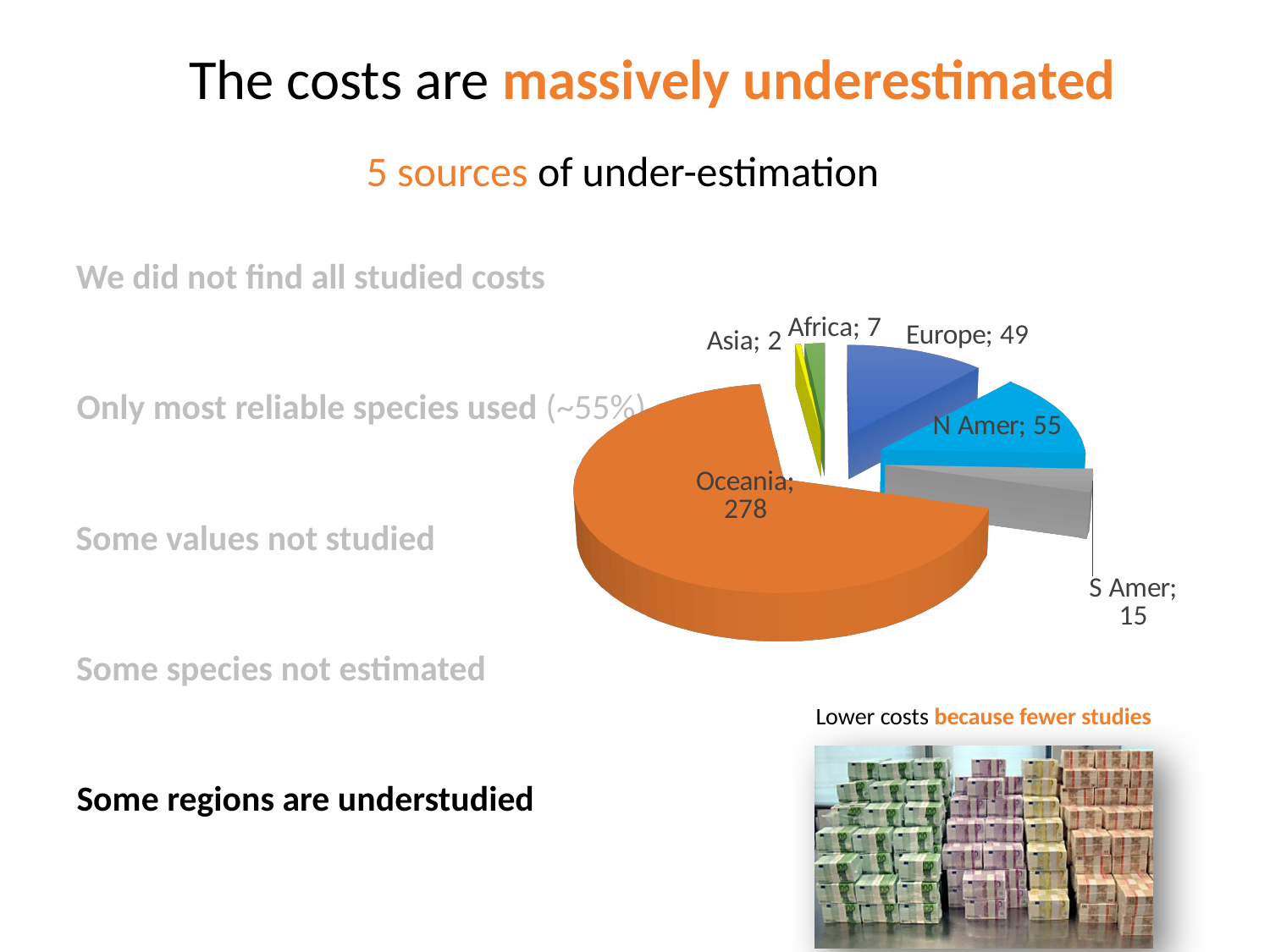
Which region has the smallest slice in the pie chart? Asia What is the value for S Amer in the pie chart? 15 What is the value for Oceania in the pie chart? 278 Which is larger, the value for Africa or the value for S Amer? S Amer Which region has the largest slice in the pie chart? Oceania What kind of chart is shown on the slide? pie chart What is the difference between the values for Oceania and N Amer? 223 What is the value for N Amer in the pie chart? 55 How many regions are shown in the pie chart? 6 What is the value for Europe in the pie chart? 49 What is the difference between the values for N Amer and Europe? 6 What is the value for Asia in the pie chart? 2